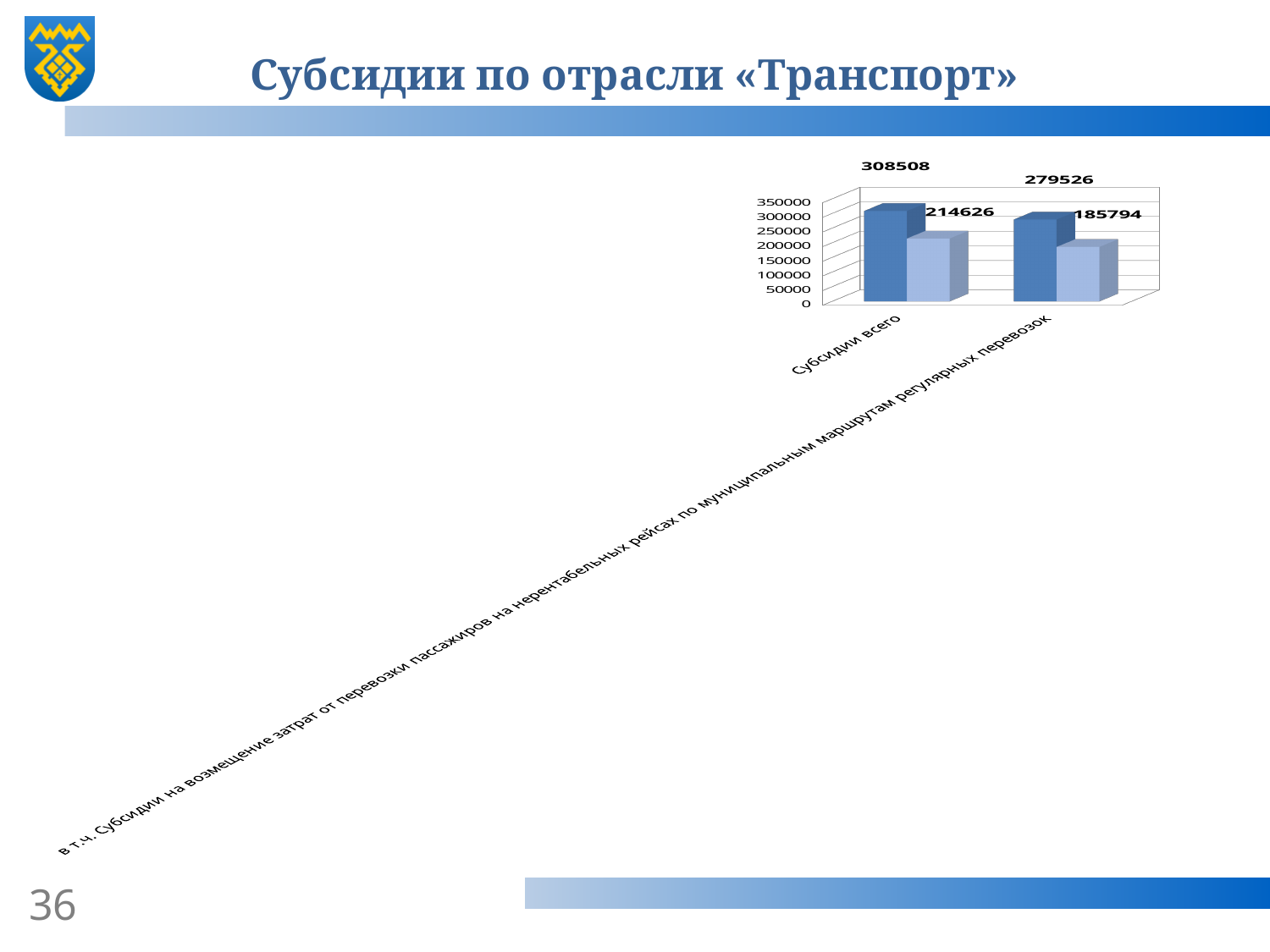
What is the difference between the dark blue bars of the two categories? 28982 What is the difference between the dark blue and light blue bars for "Субсидии всего"? 93882 Which is larger: the light blue bar for "Субсидии всего" or the light blue bar for the second category? the light blue bar for Субсидии всего What is the value of the dark blue bar for "Субсидии всего"? 308508 What is the title of the slide containing the chart? Субсидии по отрасли «Транспорт» What is the value of the light blue bar for the category "в т.ч. Субсидии на возмещение затрат от перевозки пассажиров на нерентабельных рейсах по муниципальным маршрутам регулярных перевозок"? 185794 What type of chart is shown on the slide? bar chart Which bar has the lowest value on the chart? the light blue bar for в т.ч. Субсидии на возмещение затрат... (185794) What is the value of the light blue bar for "Субсидии всего"? 214626 Which bar has the highest value on the chart? the dark blue bar for Субсидии всего (308508) How many categories are shown on the x axis of the chart? 2 What is the value of the dark blue bar for the category "в т.ч. Субсидии на возмещение затрат от перевозки пассажиров на нерентабельных рейсах по муниципальным маршрутам регулярных перевозок"? 279526